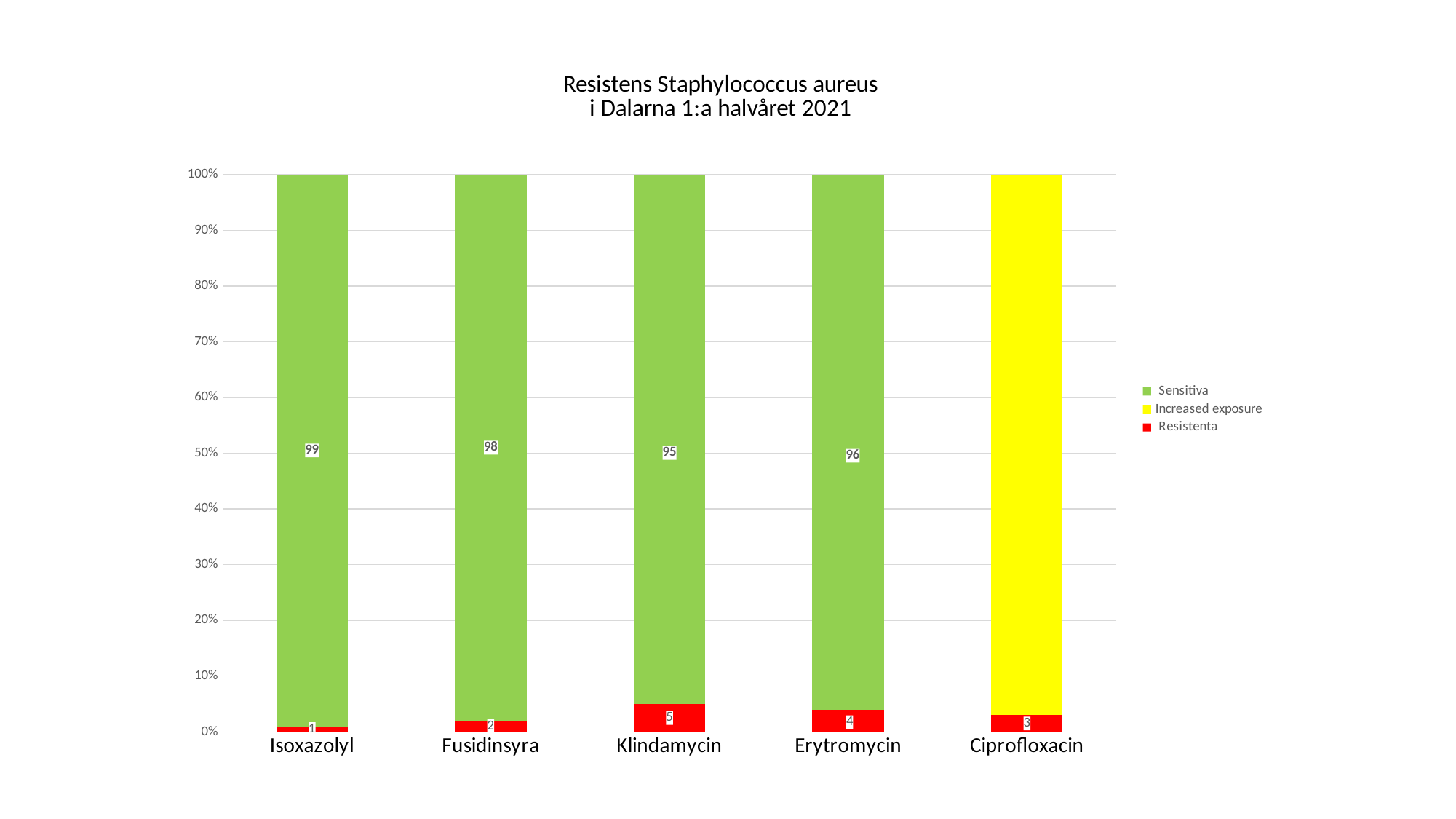
Which antibiotic has the highest Resistenta value? Klindamycin Which antibiotic has the lowest Resistenta value? Isoxazolyl What is the Sensitiva value for Erytromycin? 96 How many series does the legend list? 3 What is the difference between the Sensitiva values for Fusidinsyra and Klindamycin? 3 Is the Increased exposure share for Ciprofloxacin greater or less than 90%? greater What kind of chart is shown on the slide? Stacked bar chart How many antibiotics are shown on the x axis? 5 What is the Resistenta value for Klindamycin? 5 What is the Sensitiva value for Isoxazolyl? 99 Which has a larger Resistenta value, Erytromycin or Fusidinsyra? Erytromycin What is the Resistenta value for Ciprofloxacin? 3